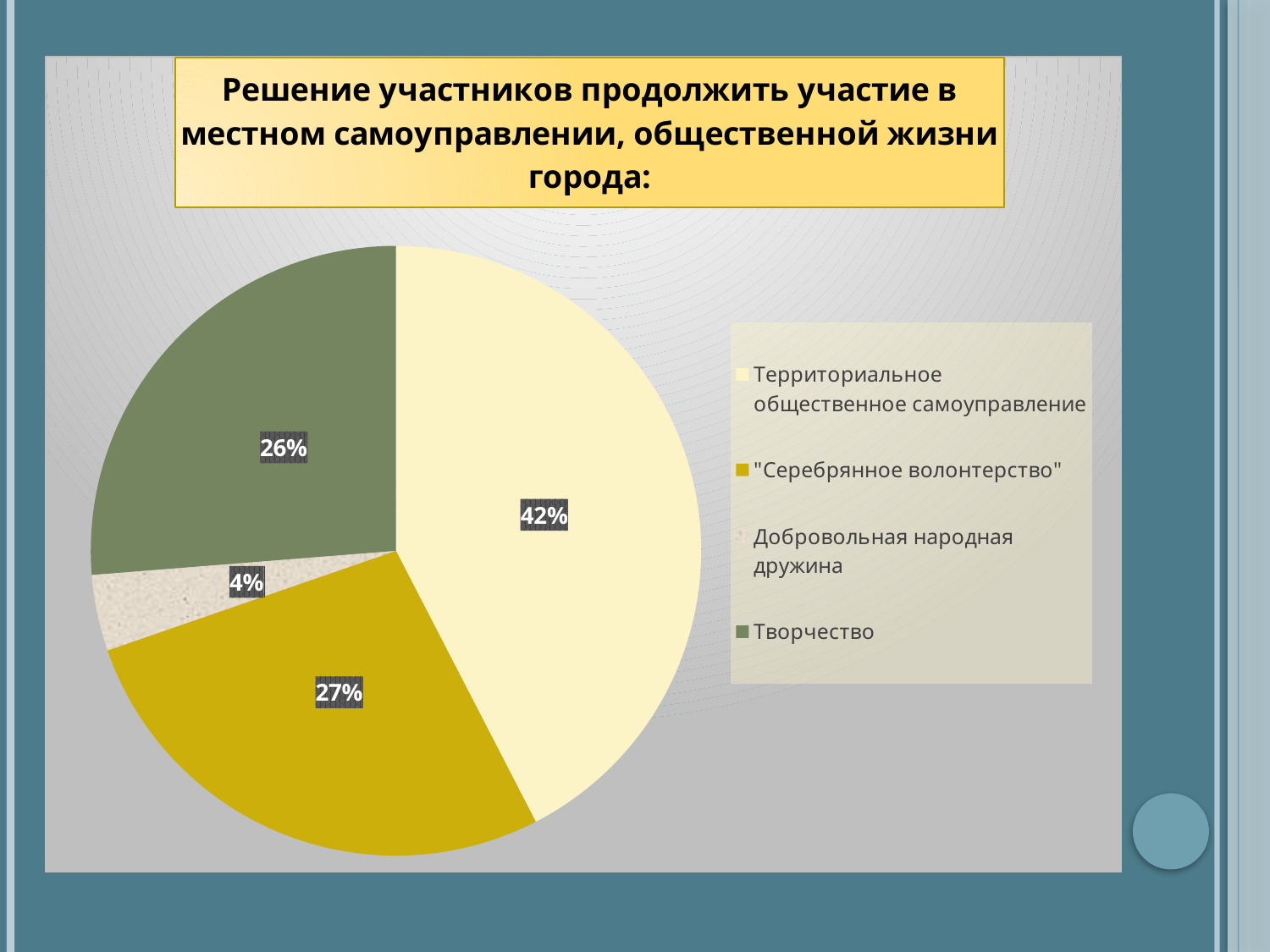
How many entries does the legend list? 4 How many slices does the pie chart have? 4 What is the difference in percentage points between "Территориальное общественное самоуправление" and "Творчество"? 16% What share of the pie does "Добровольная народная дружина" have? 4% What share of the pie does "Серебрянное волонтерство" have? 27% Which category has the smallest slice of the pie? Добровольная народная дружина What is the title of the chart? Решение участников продолжить участие в местном самоуправлении, общественной жизни города: What kind of chart is shown on the slide? pie chart What share of the pie does "Территориальное общественное самоуправление" have? 42% Which is larger: the slice for "Серебрянное волонтерство" or the slice for "Творчество"? Серебрянное волонтерство Which category has the largest slice of the pie? Территориальное общественное самоуправление